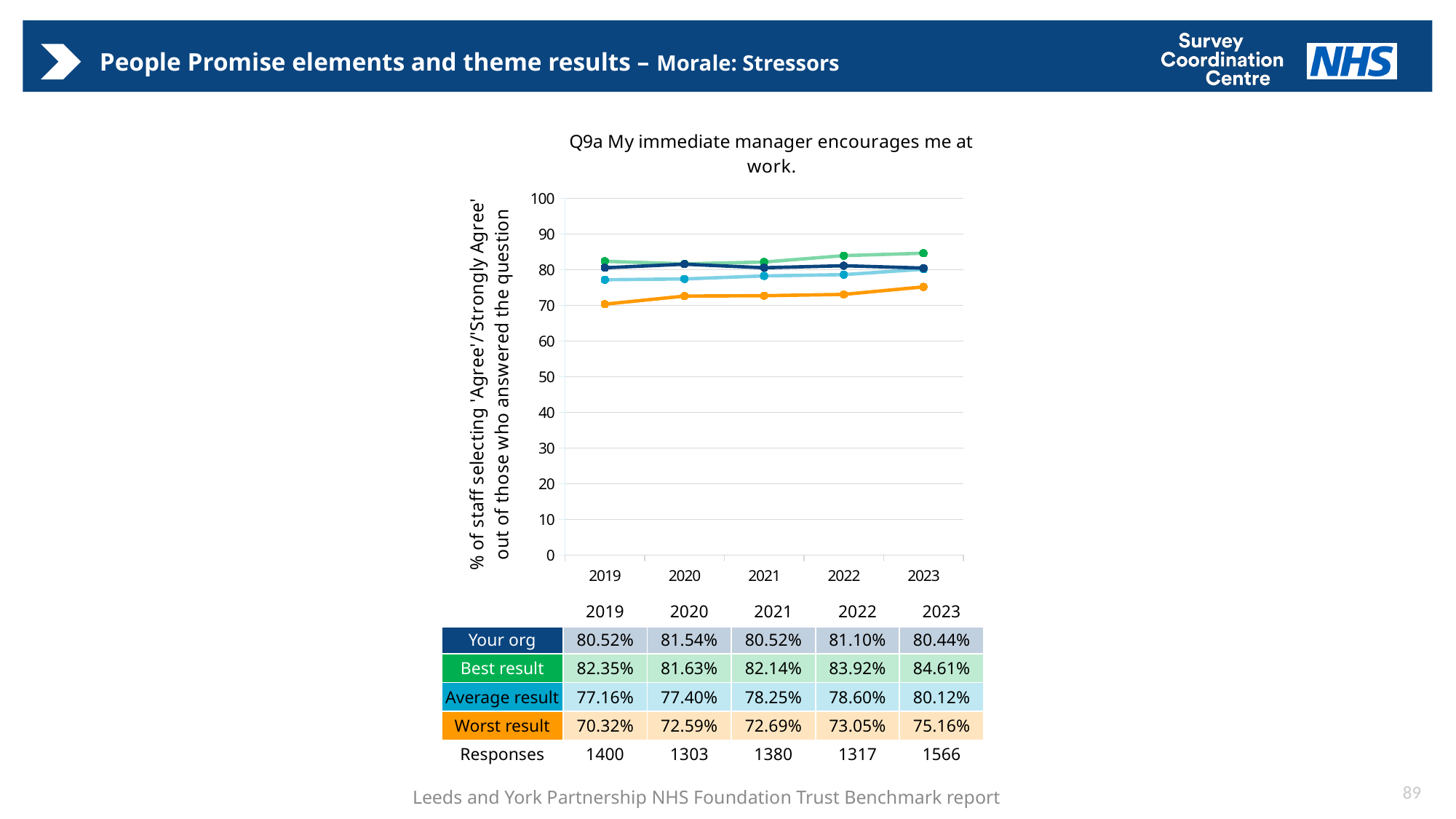
What is the value for Your org in 2023? 80.44% Does the Worst result series rise or fall from 2019 to 2023? rise What is the Worst result value in 2019? 70.32% In which year is the Best result series highest? 2023 How many years are shown on the x axis? 5 What kind of chart is shown on the slide? line chart Which is larger in 2022, Your org or the Average result? Your org What is the Average result value in 2021? 78.25% In which year is the Worst result series lowest? 2019 What is the difference between the Best result and Your org in 2023? 4.17 percentage points Is the Worst result value for 2019 greater or less than 80? less What is the Best result value in 2022? 83.92%